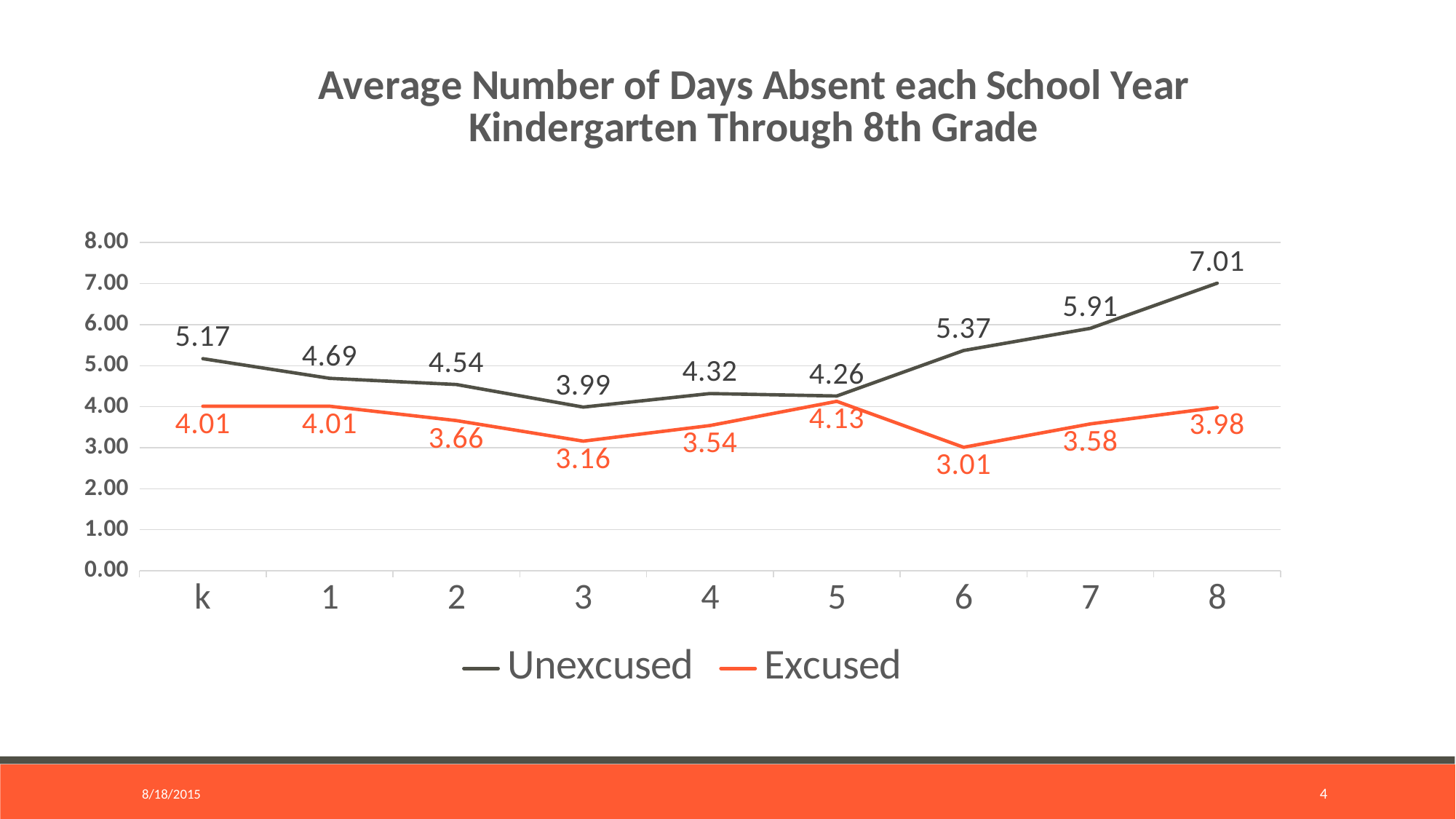
Which is larger in grade 5, the Unexcused value or the Excused value? Unexcused What is the Unexcused value for kindergarten (k)? 5.17 How many series does the legend list? 2 What is the average number of excused days absent in grade 3? 3.16 Which grade has the lowest Excused value? 6 How many grade levels are plotted on the x axis? 9 Does the Unexcused line rise or fall from grade 5 to grade 8? Rise What kind of chart is shown on the slide? Line chart What is the difference between the Unexcused and Excused values in grade 6? 2.36 What is the average number of unexcused days absent in grade 8? 7.01 Which grade has the highest Unexcused value? 8 Which grade has the lowest Unexcused value? 3